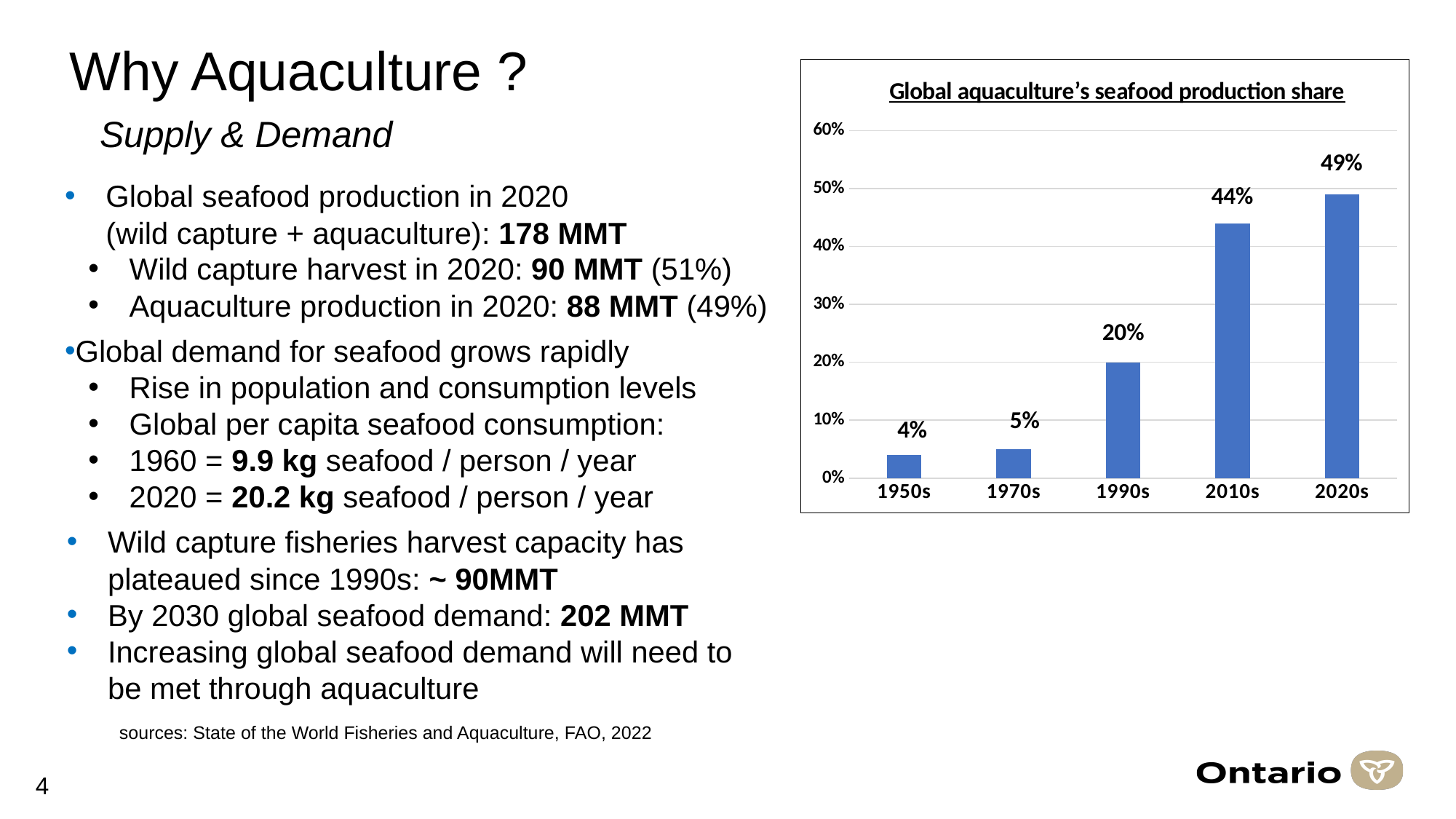
What is the title of the chart? Global aquaculture's seafood production share Which is larger, the value for the 1970s or the value for the 2010s? 2010s What is the value for the 1950s in the chart? 4% What kind of chart is shown on the slide? bar chart Is the value for the 2010s greater or less than 40%? greater How many decades are shown on the x axis of the chart? 5 What is the value for the 1990s in the chart? 20% What is the difference between the values for the 2020s and the 1990s? 29% What is the value for the 2010s in the chart? 44% Do the values rise or fall from the 1950s to the 2020s? rise Which decade has the lowest aquaculture seafood production share? 1950s Which decade has the highest aquaculture seafood production share? 2020s